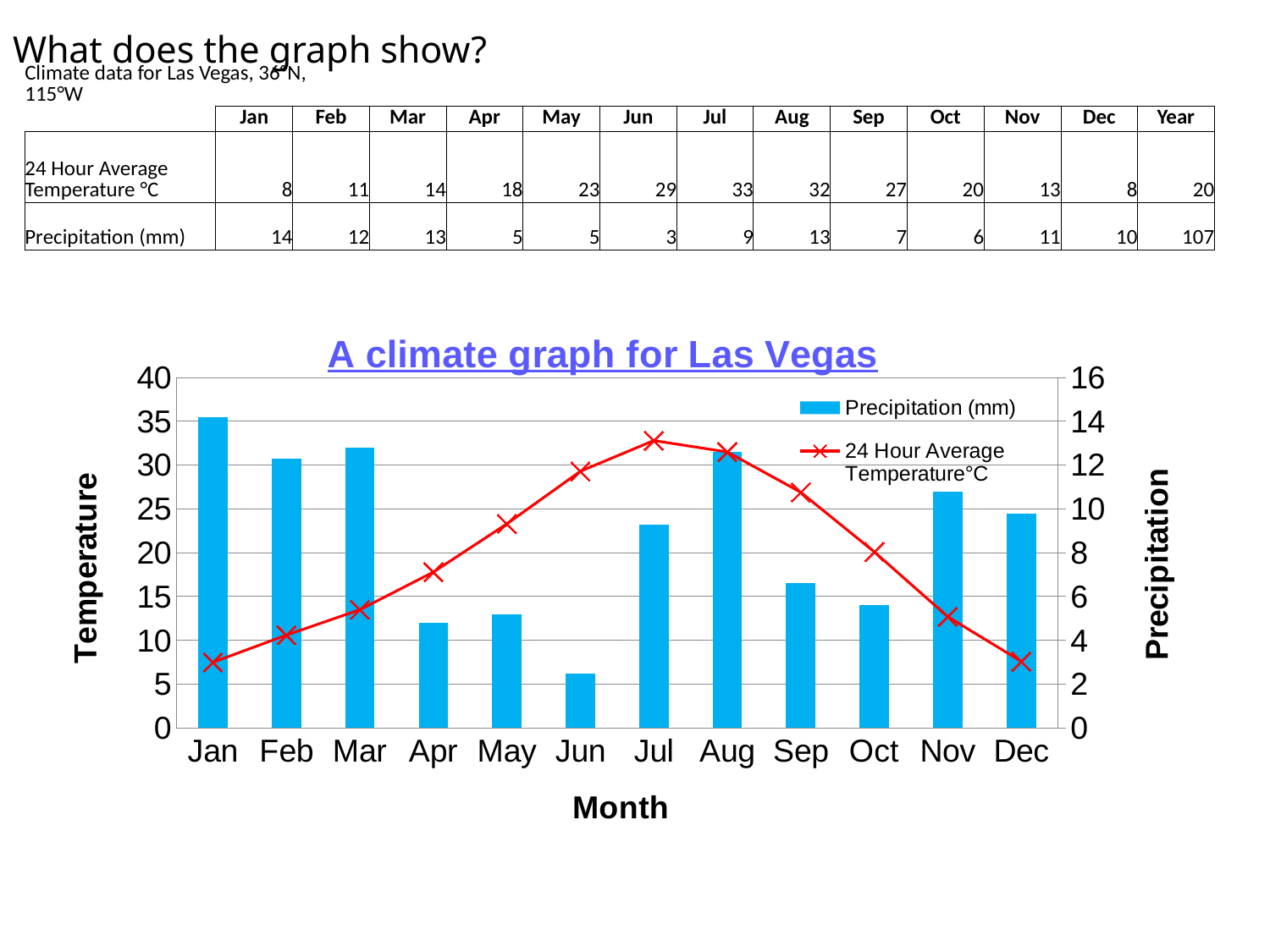
Is the 24 Hour Average Temperature for Jul greater or less than 30? greater How many series does the chart legend list? 2 What is the precipitation (mm) for Jun? 3 What kind of chart is shown on the slide? A combined bar and line chart Which month has the larger precipitation, Jan or Jul? Jan Which month has the highest 24 Hour Average Temperature in the chart? Jul How many months are plotted along the x axis of the chart? 12 Which month has the highest precipitation bar in the chart? Jan What is the 24 Hour Average Temperature for Jul? 33 What is the title of the chart? A climate graph for Las Vegas What is the difference between the 24 Hour Average Temperature in Jul and in Jan? 25 Which month has the lowest precipitation bar in the chart? Jun